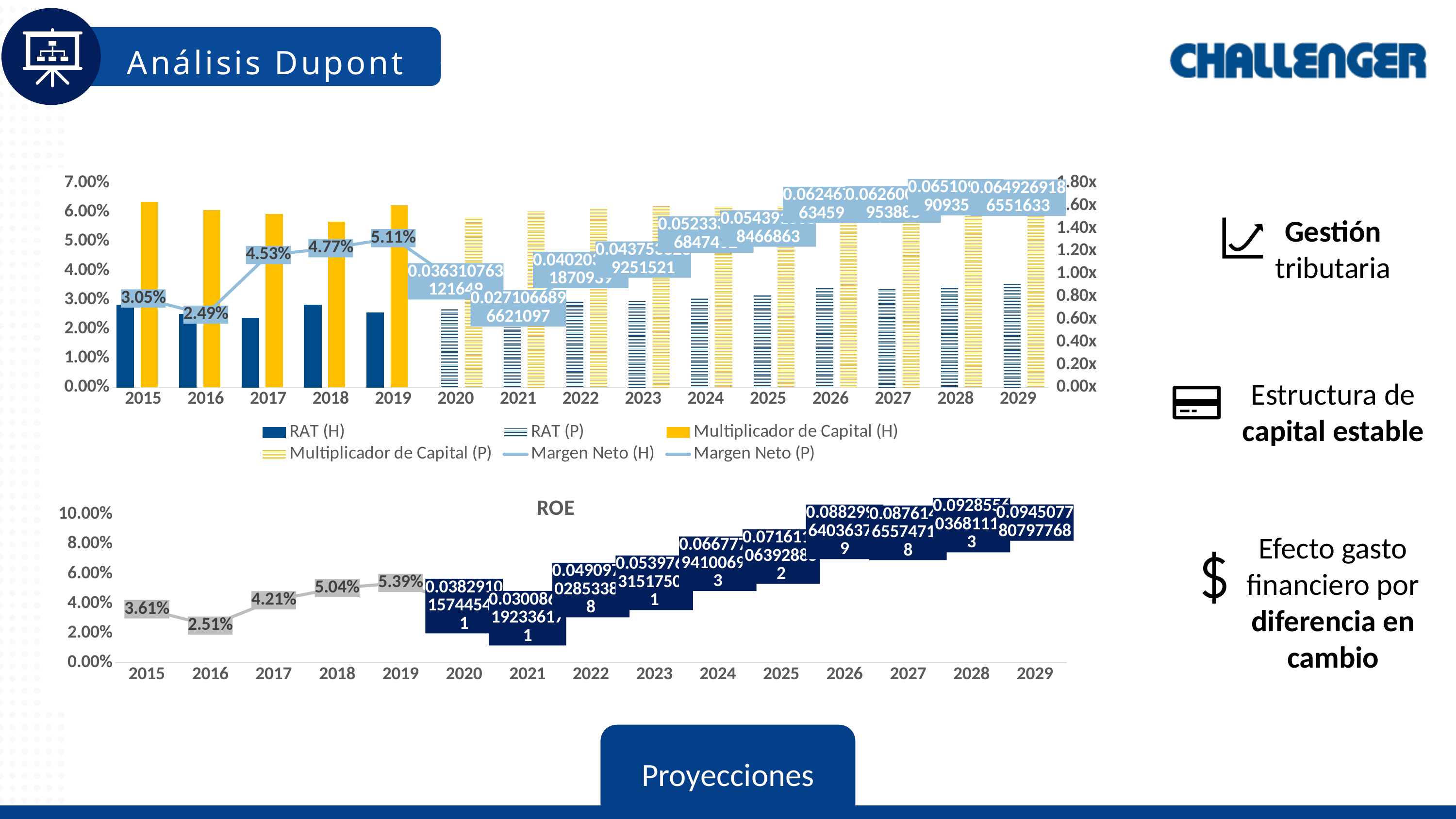
How many series does the legend of the top chart list? 6 How many years are shown on the x axis of the top chart? 15 In the top chart, what is the difference between the Margen Neto (H) values for 2019 and 2015? 2.06% In the top chart, what is the Margen Neto (H) value for 2016? 2.49% In the ROE chart, what is the value for 2018? 5.04% What is the title of the bottom chart? ROE In the top chart, which year from 2015 to 2019 has the lowest Margen Neto (H)? 2016 In the top chart, which is larger: the Margen Neto (H) for 2017 or for 2018? 2018 In the top chart, what is the Margen Neto (H) value for 2019? 5.11% In the ROE chart, what is the difference between the values for 2019 and 2015? 1.78% In the ROE chart, do the values generally rise or fall from 2020 to 2029? rise In the top chart, is the Multiplicador de Capital (H) value for 2015 greater or less than 1.40x? greater